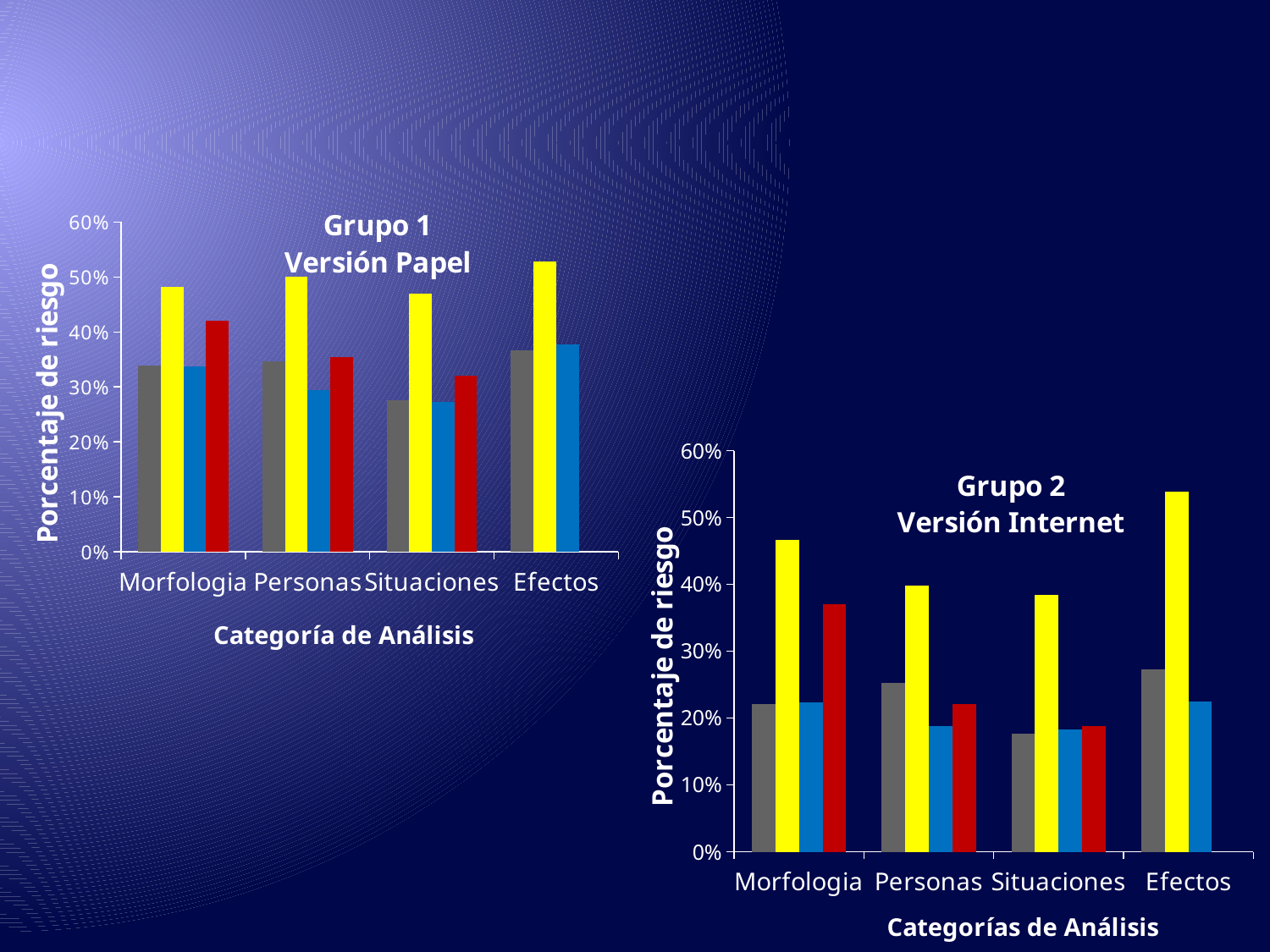
What kind of chart is the Grupo 1 Versión Papel chart? bar chart In the Grupo 1 Versión Papel chart, is the yellow bar for Efectos greater or less than 50%? greater In the Grupo 2 Versión Internet chart, how many bars are shown for the Efectos category? 3 How many categories are shown on the x axis of the Grupo 2 Versión Internet chart? 4 In the Grupo 2 Versión Internet chart, is the gray bar for Situaciones greater or less than 20%? less In the Grupo 2 Versión Internet chart, which category has the lowest gray bar? Situaciones What is the y-axis title of the Grupo 2 Versión Internet chart? Porcentaje de riesgo In the Grupo 2 Versión Internet chart, for Morfologia, which is taller: the yellow bar or the red bar? the yellow bar In the Grupo 1 Versión Papel chart, is the red bar for Morfologia greater or less than 40%? greater What is the x-axis title of the Grupo 1 Versión Papel chart? Categoría de Análisis In the Grupo 1 Versión Papel chart, which category has the tallest yellow bar? Efectos In the Grupo 2 Versión Internet chart, which category has the tallest yellow bar? Efectos